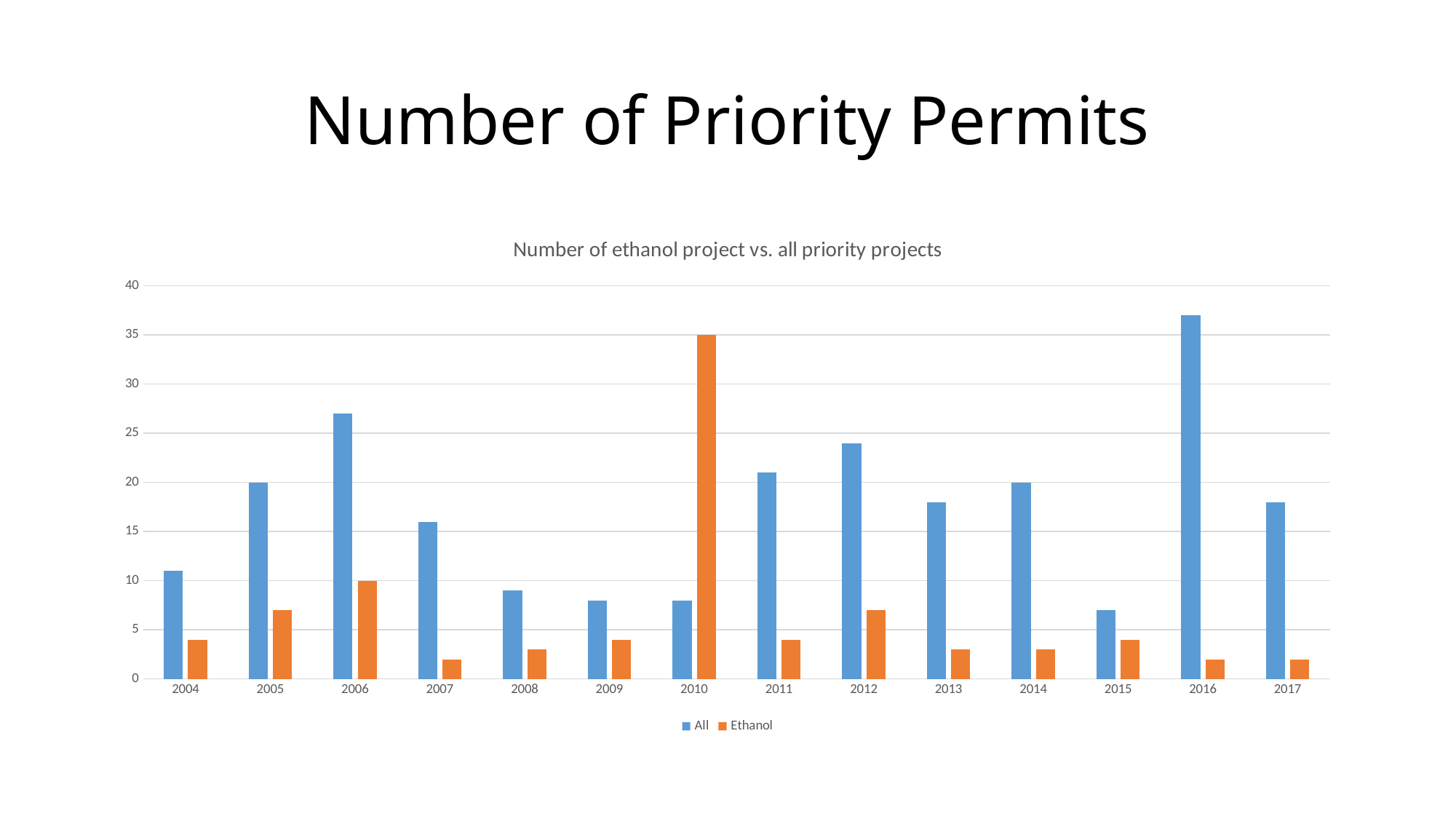
How many years are shown on the x axis? 14 Is the value for All in 2008 greater or less than 10? less What is the value for All in 2005? 20 Is the value for All in 2006 greater or less than 25? greater What is the value for Ethanol in 2010? 35 Which colour represents the Ethanol series? orange In which year is the Ethanol series highest? 2010 In which year is the All series highest? 2016 What kind of chart is shown on the slide? bar chart How many series does the legend list? 2 What is the value for Ethanol in 2006? 10 In 2010, which is larger, All or Ethanol? Ethanol